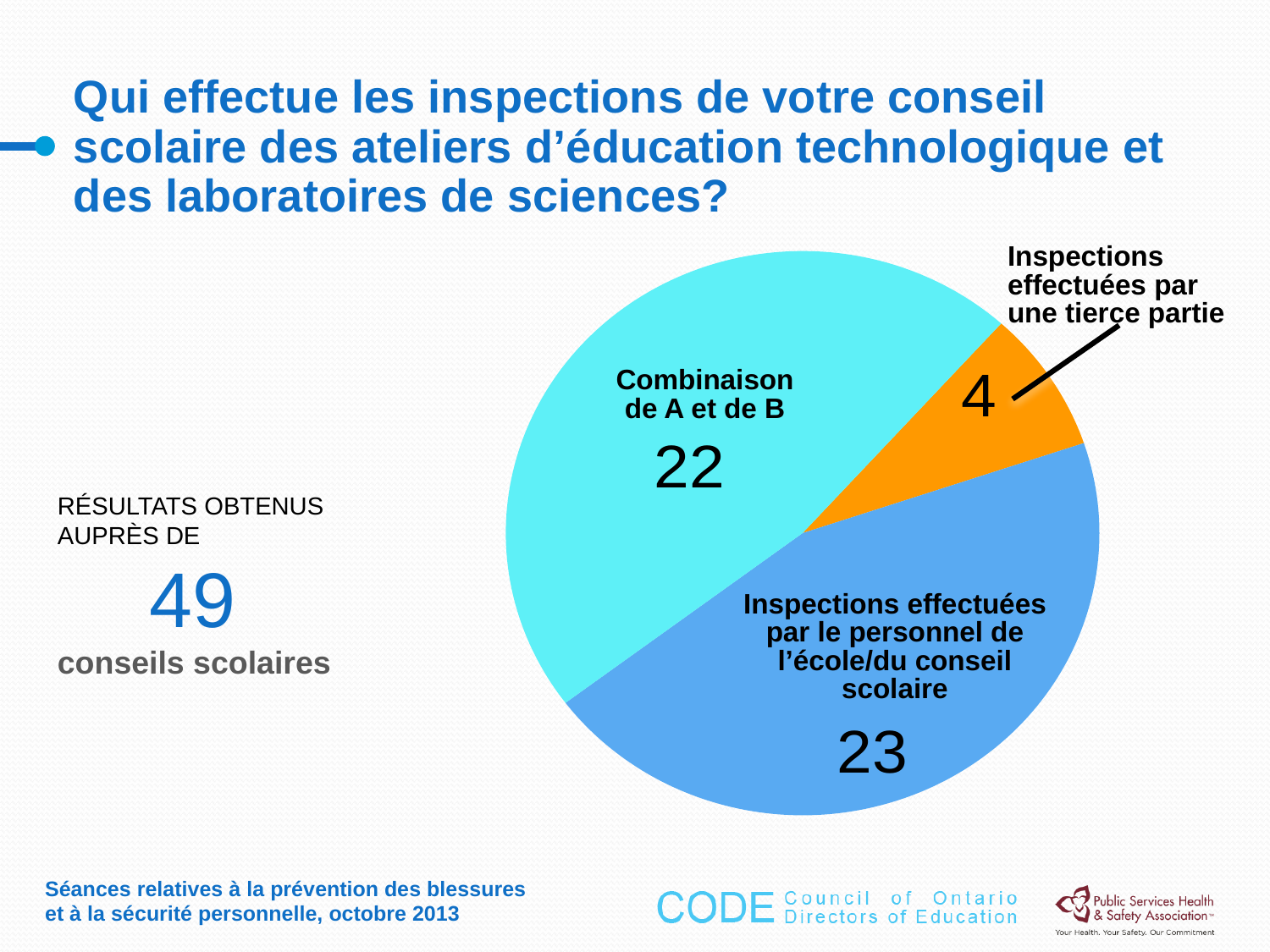
Which is larger: the value for "Combinaison de A et de B" or the value for "Inspections effectuées par une tierce partie"? Combinaison de A et de B Which category has the largest slice of the pie? Inspections effectuées par le personnel de l'école/du conseil scolaire Which category has the smallest slice of the pie? Inspections effectuées par une tierce partie What is the value for "Inspections effectuées par le personnel de l'école/du conseil scolaire"? 23 What colour is the slice for "Inspections effectuées par une tierce partie"? orange What is the value for "Inspections effectuées par une tierce partie"? 4 What is the value for "Combinaison de A et de B"? 22 How many slices does the pie chart have? 3 What is the difference between the value for "Combinaison de A et de B" and the value for "Inspections effectuées par une tierce partie"? 18 What is the difference between the value for "Inspections effectuées par le personnel de l'école/du conseil scolaire" and the value for "Combinaison de A et de B"? 1 What type of chart is shown on the slide? pie chart What is the total of all the slices in the pie chart? 49